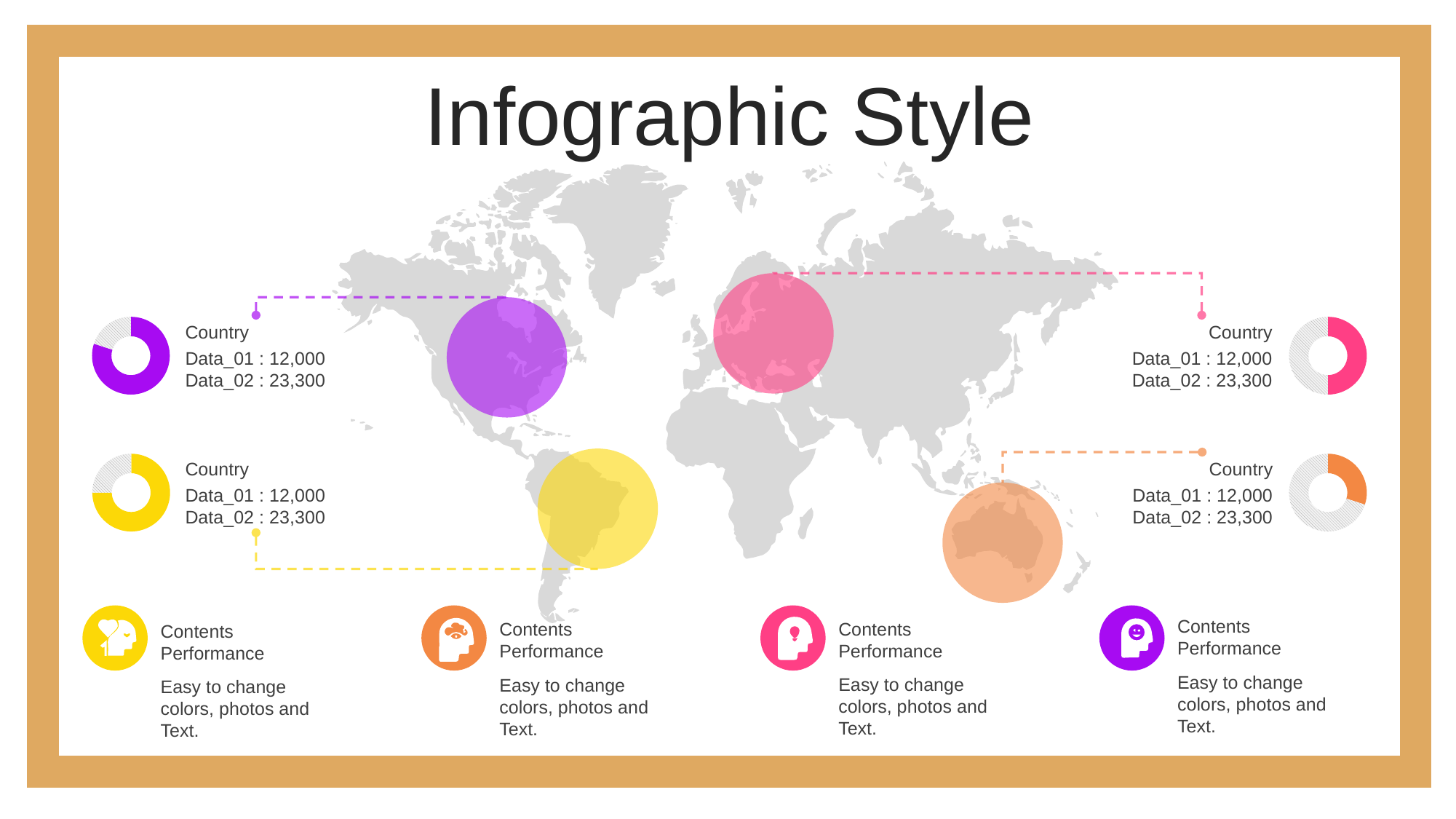
For the bottom-right orange donut chart, what is the difference between Data_02 and Data_01? 11,300 For the bottom-left yellow donut chart, what is the value of Data_02? 23,300 For the top-right pink donut chart, which is larger, Data_01 or Data_02? Data_02 For the top-left purple donut chart, what is the value of Data_01? 12,000 How many donut charts are on the slide? 4 For the bottom-left yellow donut chart, which data item has the smallest value? Data_01 For the top-left purple donut chart, what is the value of Data_02? 23,300 What label appears above the data values next to each donut chart? Country For the top-right pink donut chart, what is the value of Data_01? 12,000 What colour is the donut chart in the top-right of the slide? Pink For the bottom-right orange donut chart, what is the value of Data_02? 23,300 What kind of chart is shown next to each 'Country' label on the slide? Donut chart